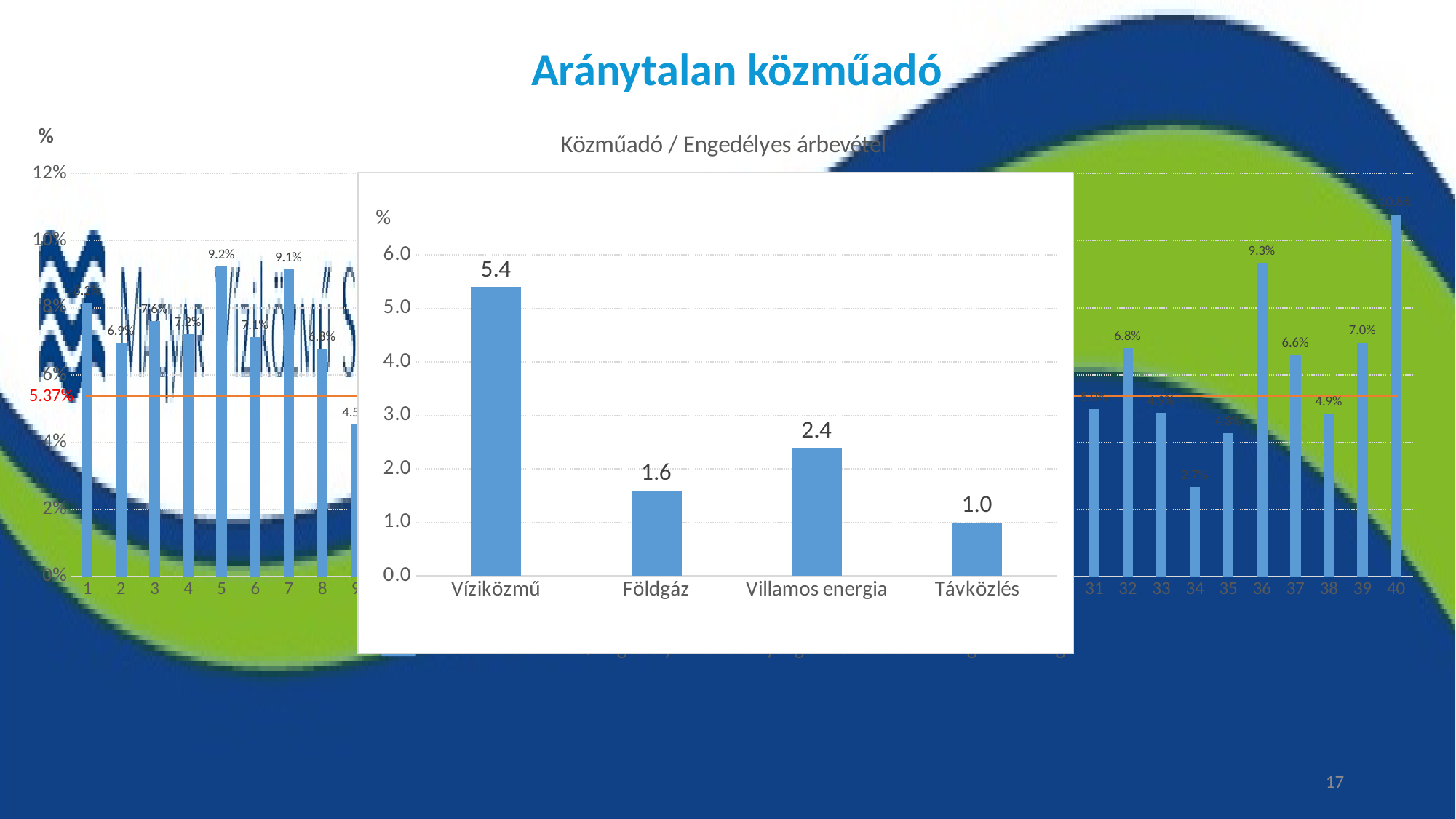
In the background chart titled 'Közműadó / Engedélyes árbevétel', what is the value labelled for bar 36? 9.3% How many categories does the foreground chart show? 4 In the foreground chart, what is the difference between the values for Víziközmű and Villamos energia? 3.0 In the foreground chart, what is the value for Távközlés? 1.0 In the foreground chart, which category has the highest value? Víziközmű In the foreground chart, what is the value for Villamos energia? 2.4 In the background chart titled 'Közműadó / Engedélyes árbevétel', what value is marked by the red horizontal reference line? 5.37% In the foreground chart (the one with four categories), what is the value for Víziközmű? 5.4 In the foreground chart, which category has the lowest value? Távközlés In the foreground chart, what is the value for Földgáz? 1.6 In the foreground chart, which is larger, the value for Földgáz or the value for Villamos energia? Villamos energia What type of chart is the foreground chart? Bar chart